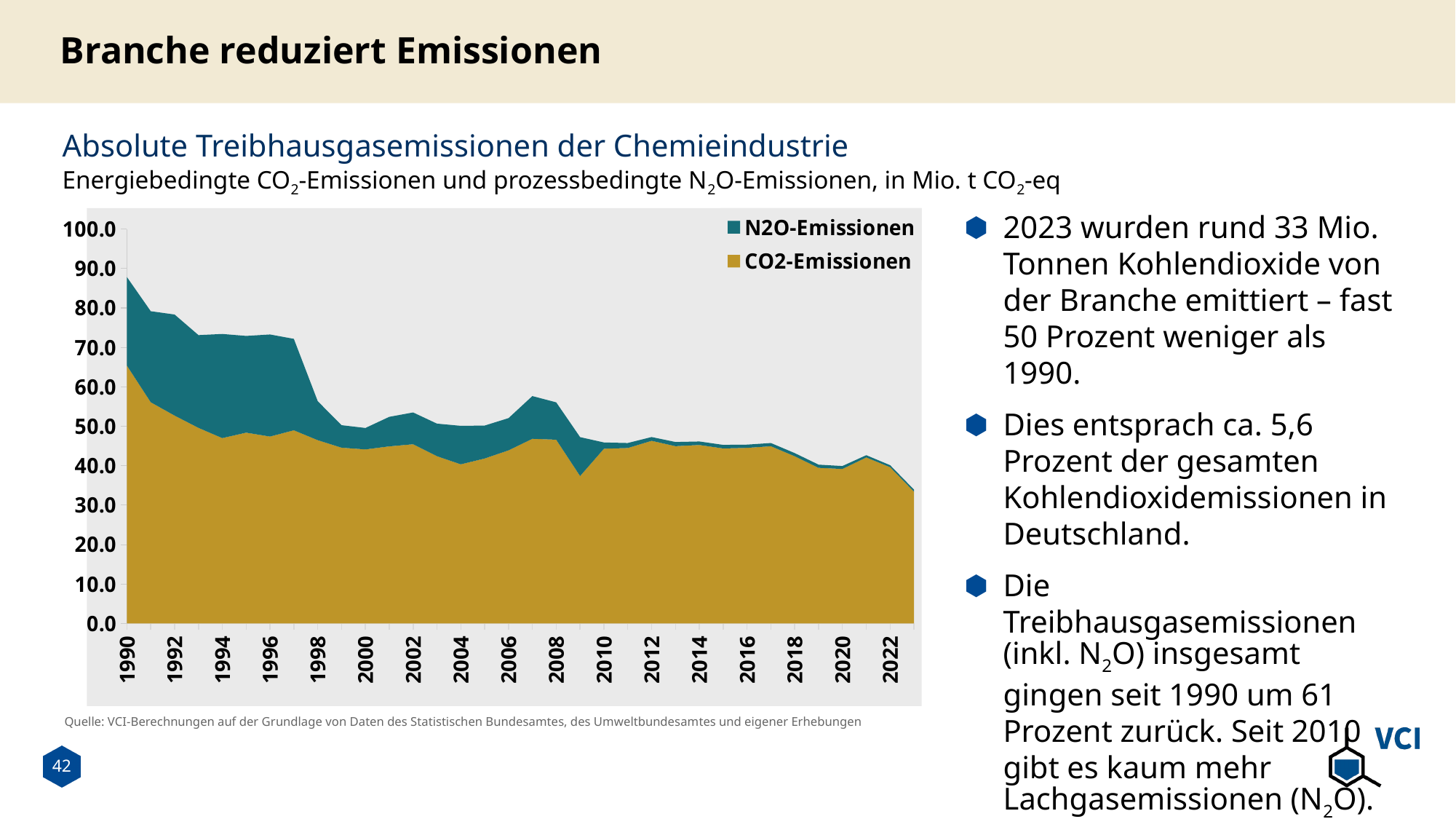
What kind of chart is shown on the slide? Stacked area chart How many series does the chart legend list? 2 Which is larger, the N2O-Emissionen value in 1990 or in 2020? 1990 Is the value for CO2-Emissionen in 2004 greater or less than 50.0? less Is the value for CO2-Emissionen in 1990 greater or less than 60.0? greater Do the total greenhouse gas emissions rise or fall from 1990 to 2023 along the x axis? Fall In which year are the total emissions (CO2 plus N2O) lowest? 2023 In which year are the total emissions (CO2 plus N2O) highest? 1990 Is the total of CO2 and N2O emissions in 2023 greater or less than 40.0? less What are the two series named in the chart legend? N2O-Emissionen and CO2-Emissionen What is the title of the chart? Absolute Treibhausgasemissionen der Chemieindustrie